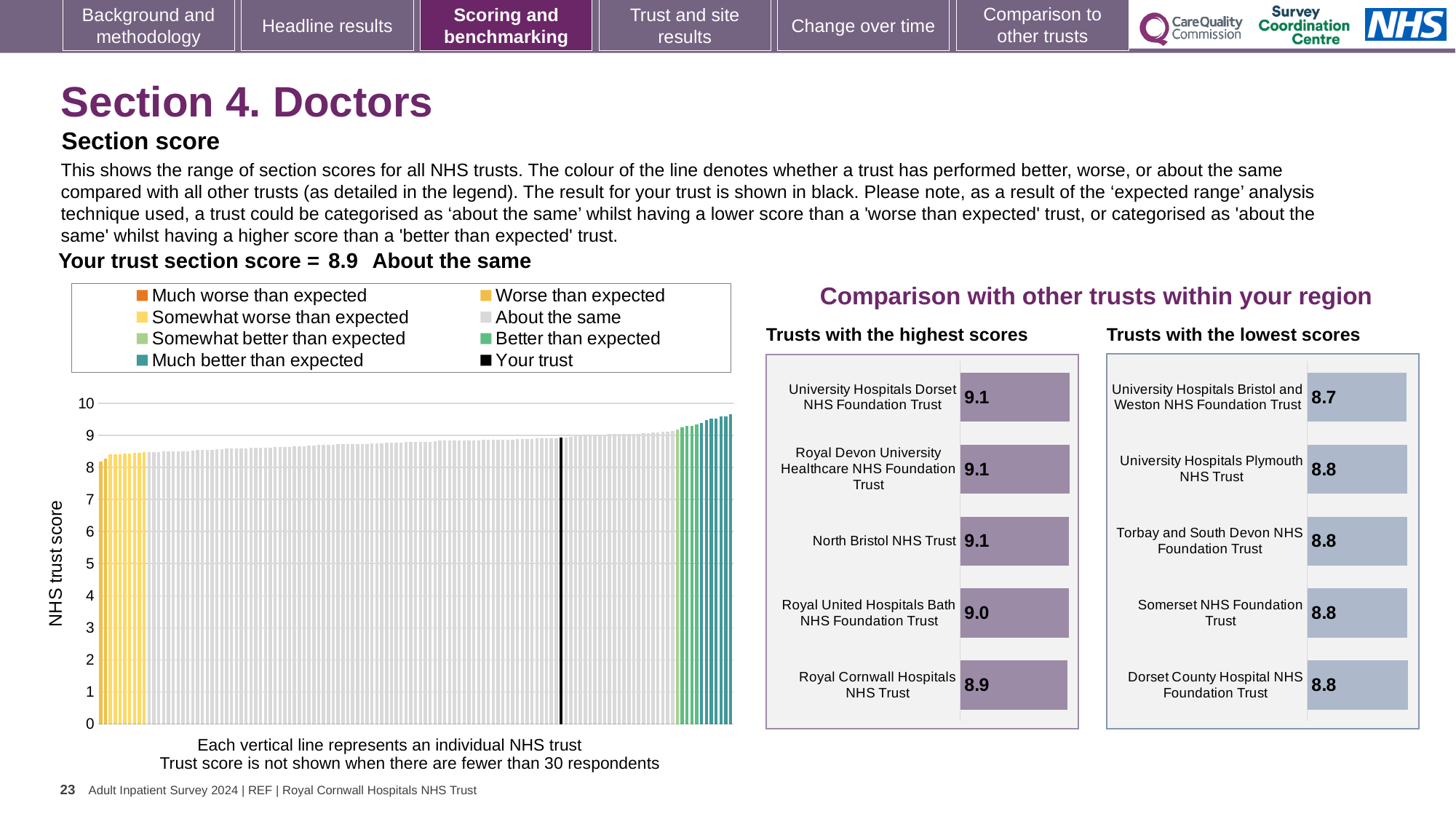
How many entries does the legend of the large chart on the left list? 8 In the 'Trusts with the highest scores' chart, what is the score for Royal Cornwall Hospitals NHS Trust? 8.9 In the 'Trusts with the highest scores' chart, which has the larger score: Royal United Hospitals Bath NHS Foundation Trust or Royal Cornwall Hospitals NHS Trust? Royal United Hospitals Bath NHS Foundation Trust In the 'Trusts with the lowest scores' chart, what is the score for University Hospitals Bristol and Weston NHS Foundation Trust? 8.7 In the 'Trusts with the lowest scores' chart, which trust has the lowest score? University Hospitals Bristol and Weston NHS Foundation Trust What kind of chart is the large chart on the left showing NHS trust scores? Bar chart How many trusts are listed in the 'Trusts with the lowest scores' chart? 5 What is the y-axis label of the large chart on the left? NHS trust score In the 'Trusts with the highest scores' chart, which trust has the lowest score shown? Royal Cornwall Hospitals NHS Trust In the large chart on the left, do the trust scores rise or fall from left to right? Rise In the 'Trusts with the highest scores' chart, what is the difference between the score for University Hospitals Dorset NHS Foundation Trust and the score for Royal Cornwall Hospitals NHS Trust? 0.2 In the 'Trusts with the highest scores' chart, what is the score for Royal United Hospitals Bath NHS Foundation Trust? 9.0